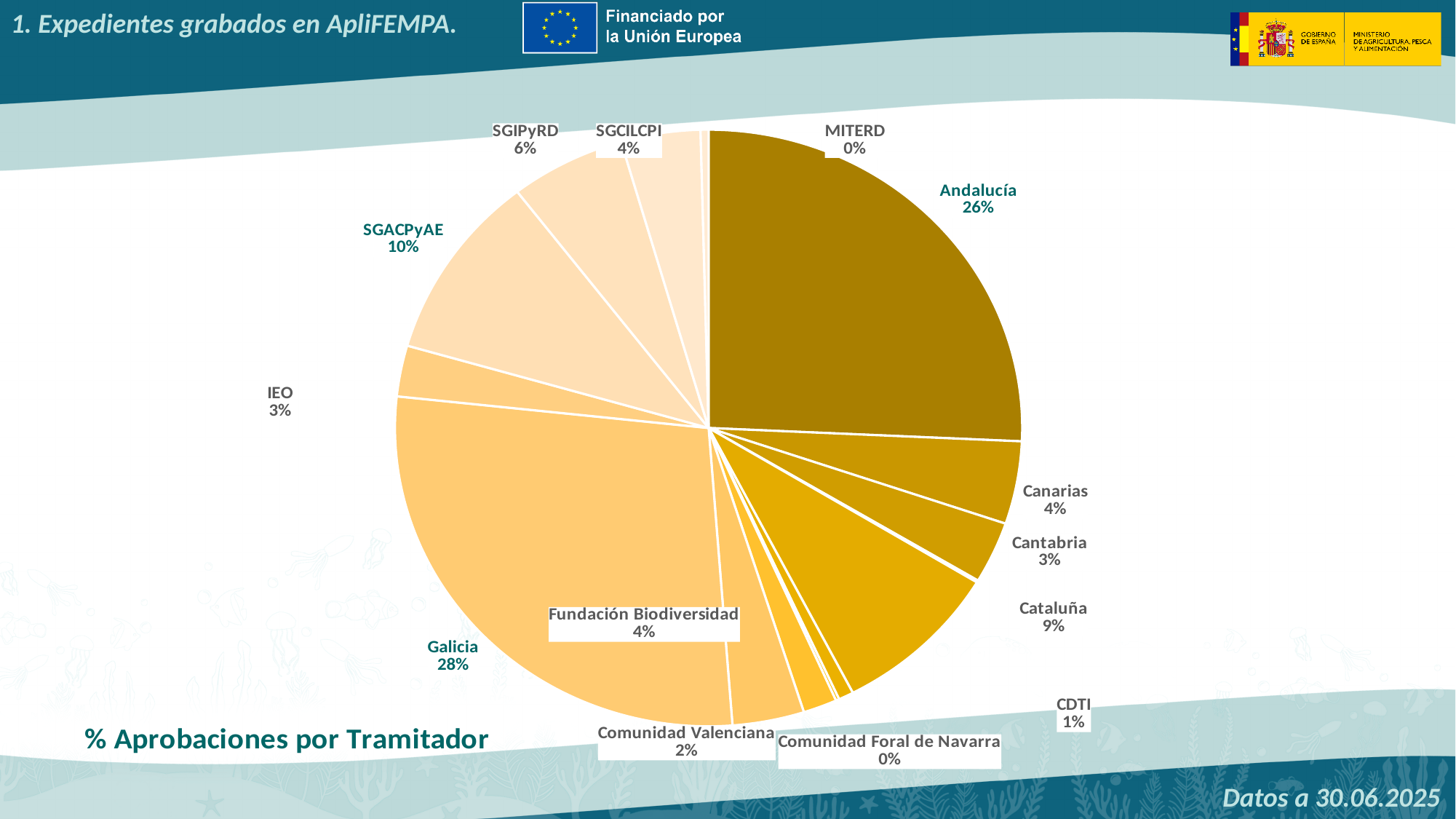
What share of the pie does Andalucía have? 26% How many categories (tramitadores) are labelled on the pie chart? 14 What is the value shown for CDTI? 1% Which tramitador has the largest share of the pie? Galicia What share of the pie does Galicia have? 28% Which is larger, the share for Cataluña or the share for SGIPyRD? Cataluña What is the value shown for Comunidad Valenciana? 2% What is the title of the chart? % Aprobaciones por Tramitador What kind of chart is shown on the slide? Pie chart What is the value shown for Cataluña? 9% What is the value shown for SGACPyAE? 10% What is the difference between the shares of Galicia and Andalucía? 2%